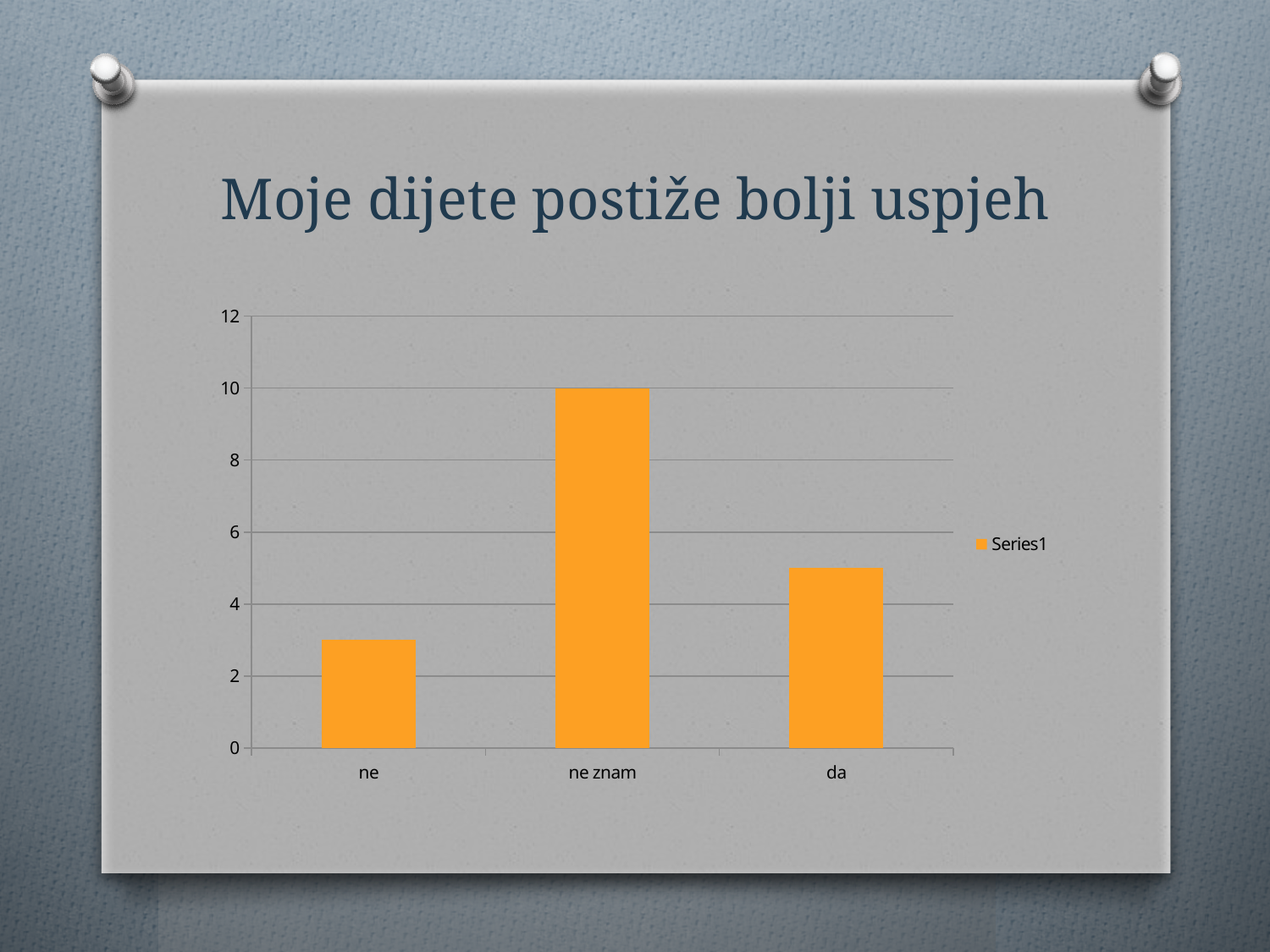
Which category has the lowest value? ne What kind of chart is shown on the slide? bar chart What is the value for "ne znam"? 10 Which is larger, the value for "da" or the value for "ne"? da Which category has the highest value? ne znam What is the title of the chart on the slide? Moje dijete postiže bolji uspjeh How many series does the legend list? 1 Is the value for "da" greater or less than 4? greater How many categories are shown on the x axis of the chart? 3 Is the value for "da" greater or less than 6? less Is the value for "ne" greater or less than 4? less What is the name of the series shown in the legend? Series1